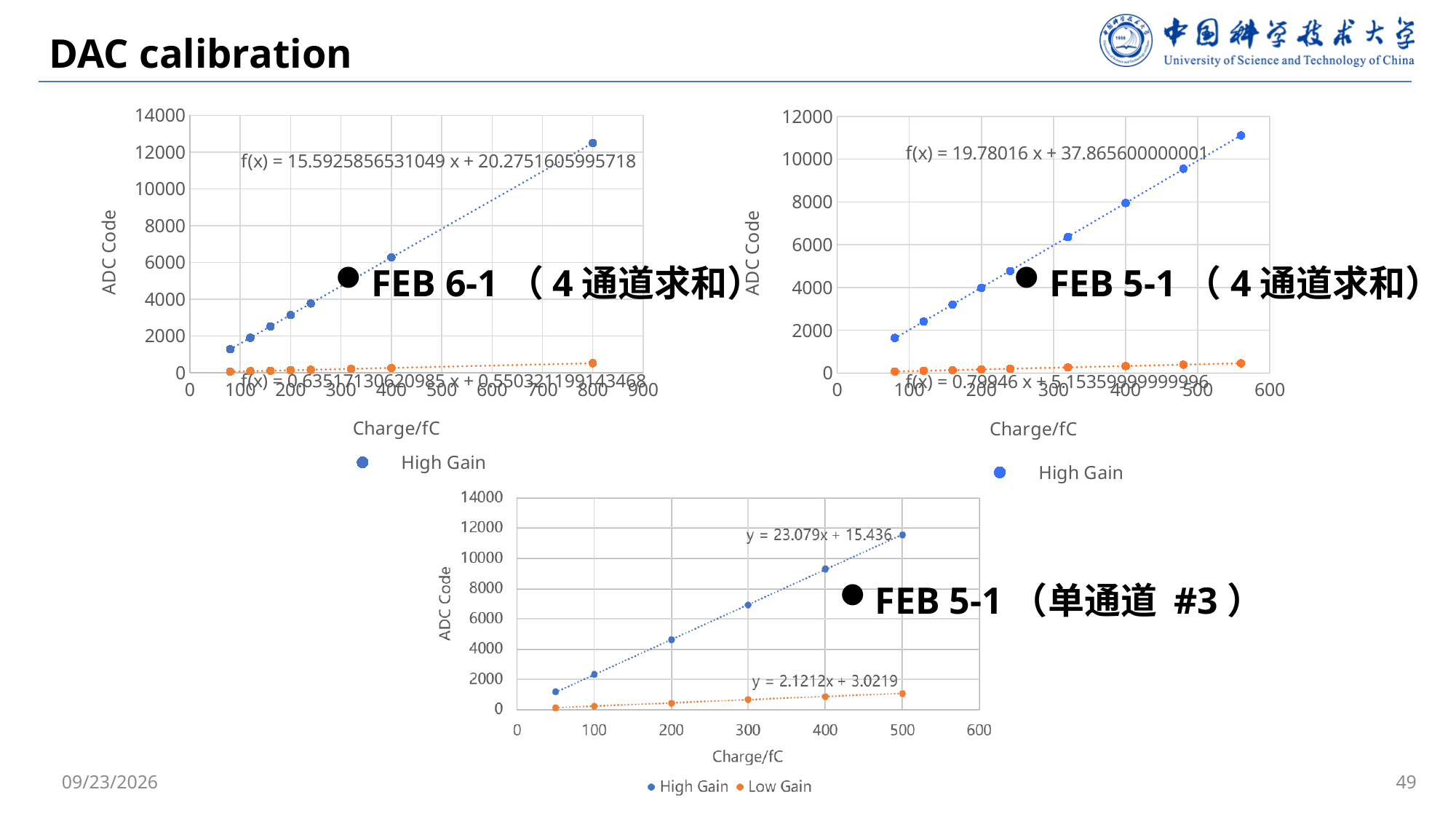
In the FEB 5-1 (4 channel sum) chart at the top right, is the High Gain value at the highest charge point greater or less than 10000? greater In the bottom FEB 5-1 (single channel #3) chart, which series has the larger value at 400 fC, High Gain or Low Gain? High Gain In the bottom FEB 5-1 (single channel #3) chart, is the Low Gain value at 500 fC greater or less than 2000? less In the FEB 6-1 chart at the top left, is the High Gain value at 800 fC greater or less than 12000? greater What kind of chart is the FEB 6-1 chart at the top left of the slide? scatter chart How many High Gain data points are plotted in the bottom FEB 5-1 (single channel #3) chart? 6 How many series does the legend of the bottom FEB 5-1 (single channel #3) chart list? 2 In the FEB 5-1 (4 channel sum) chart at the top right, do the High Gain values rise or fall as Charge/fC increases? rise What is the x-axis title of the FEB 6-1 chart at the top left? Charge/fC What trend line equation is shown for the High Gain series in the bottom FEB 5-1 (single channel #3) chart? y = 23.079x + 15.436